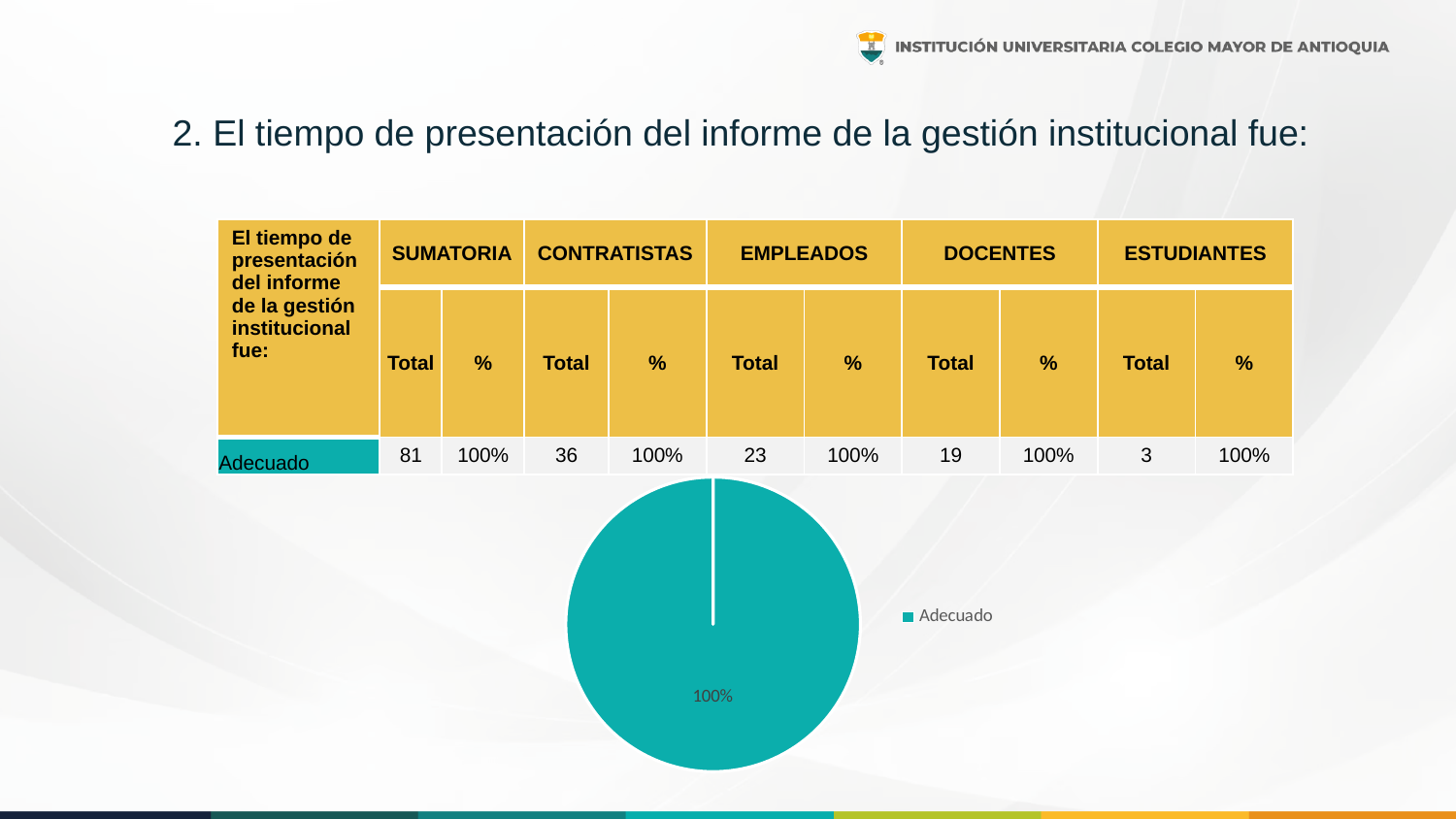
What share of the pie does the Adecuado slice represent? 100% How many entries does the chart legend list? 1 What kind of chart is shown on the slide? pie chart What is the name of the category shown in the chart legend? Adecuado What is the data label shown on the pie chart? 100% What colour is the Adecuado slice in the pie chart? teal How many slices does the pie chart have? 1